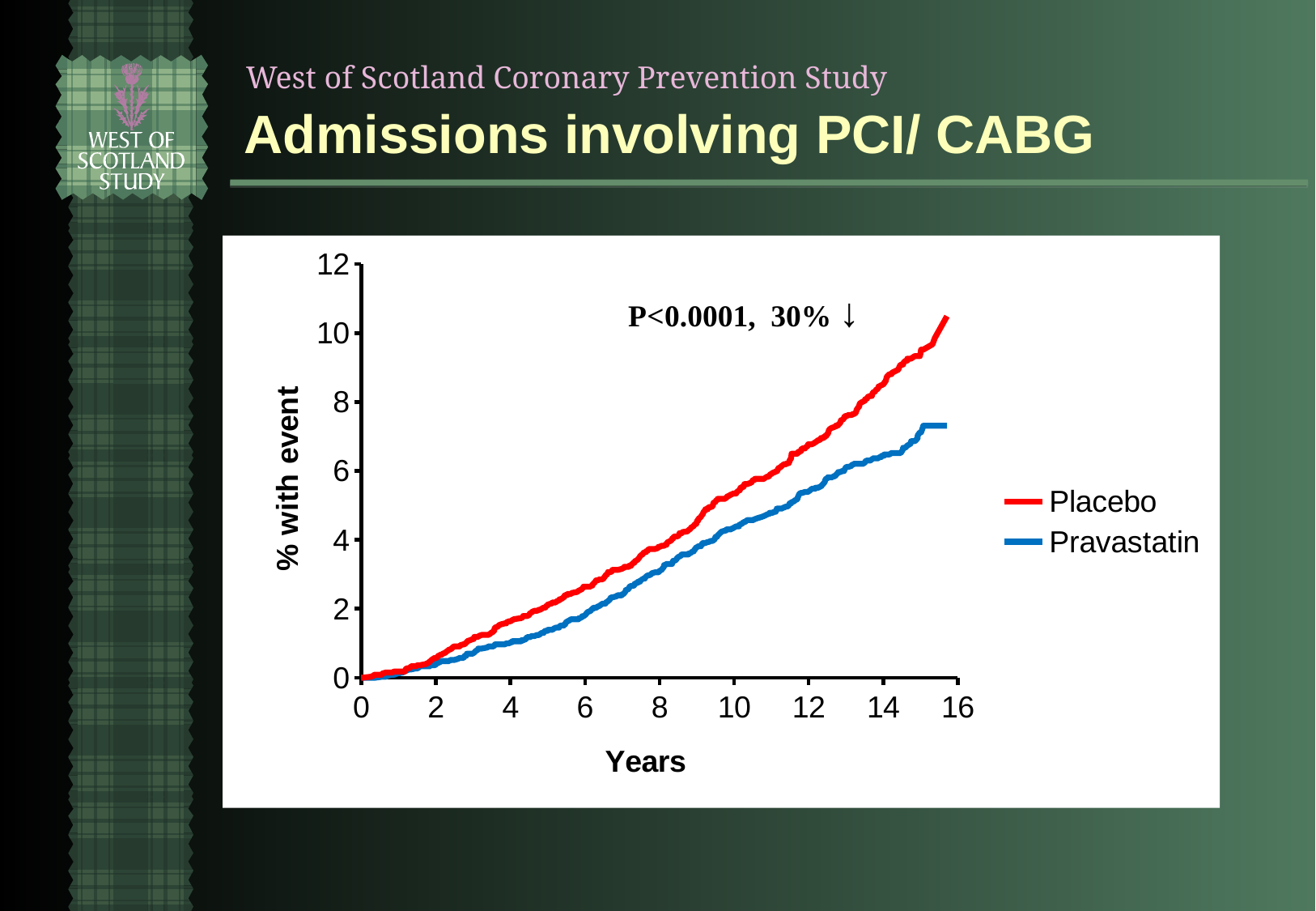
What is the label of the y axis? % with event Which series reaches the lowest % with event at the end of follow-up? Pravastatin Do the values for Pravastatin rise or fall as the years increase? rise Is the final value for Placebo at the end of follow-up greater or less than 10? greater Which series is drawn in red? Placebo Is the final value for Pravastatin at the end of follow-up greater or less than 8? less At 12 years, which series has the higher % with event, Placebo or Pravastatin? Placebo Do the values for Placebo rise or fall as the years increase? rise What kind of chart is shown on the slide? line chart Is the value for Placebo at 14 years greater or less than 8? greater How many series does the legend list? 2